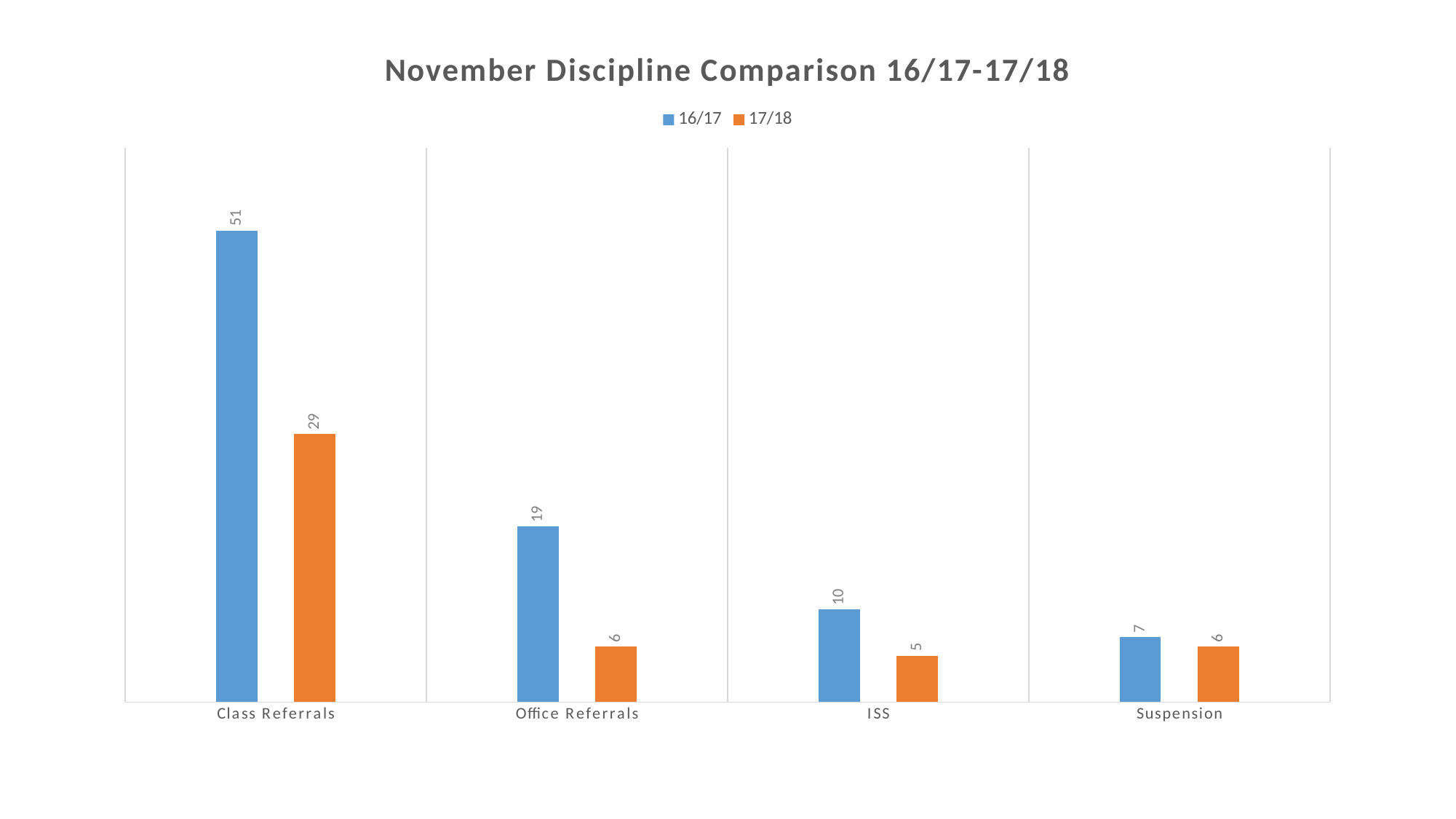
How many categories are shown on the x axis? 4 Which category has the highest 16/17 value? Class Referrals What kind of chart is shown on the slide? Bar chart Which is larger for ISS, the 16/17 value or the 17/18 value? 16/17 What is the 16/17 value for Class Referrals? 51 What is the 17/18 value for Office Referrals? 6 Which category has the lowest 17/18 value? ISS What is the 16/17 value for Suspension? 7 What is the 17/18 value for ISS? 5 How many series does the legend list? 2 What is the difference between the 16/17 and 17/18 values for Class Referrals? 22 What is the difference between the 16/17 and 17/18 values for Office Referrals? 13